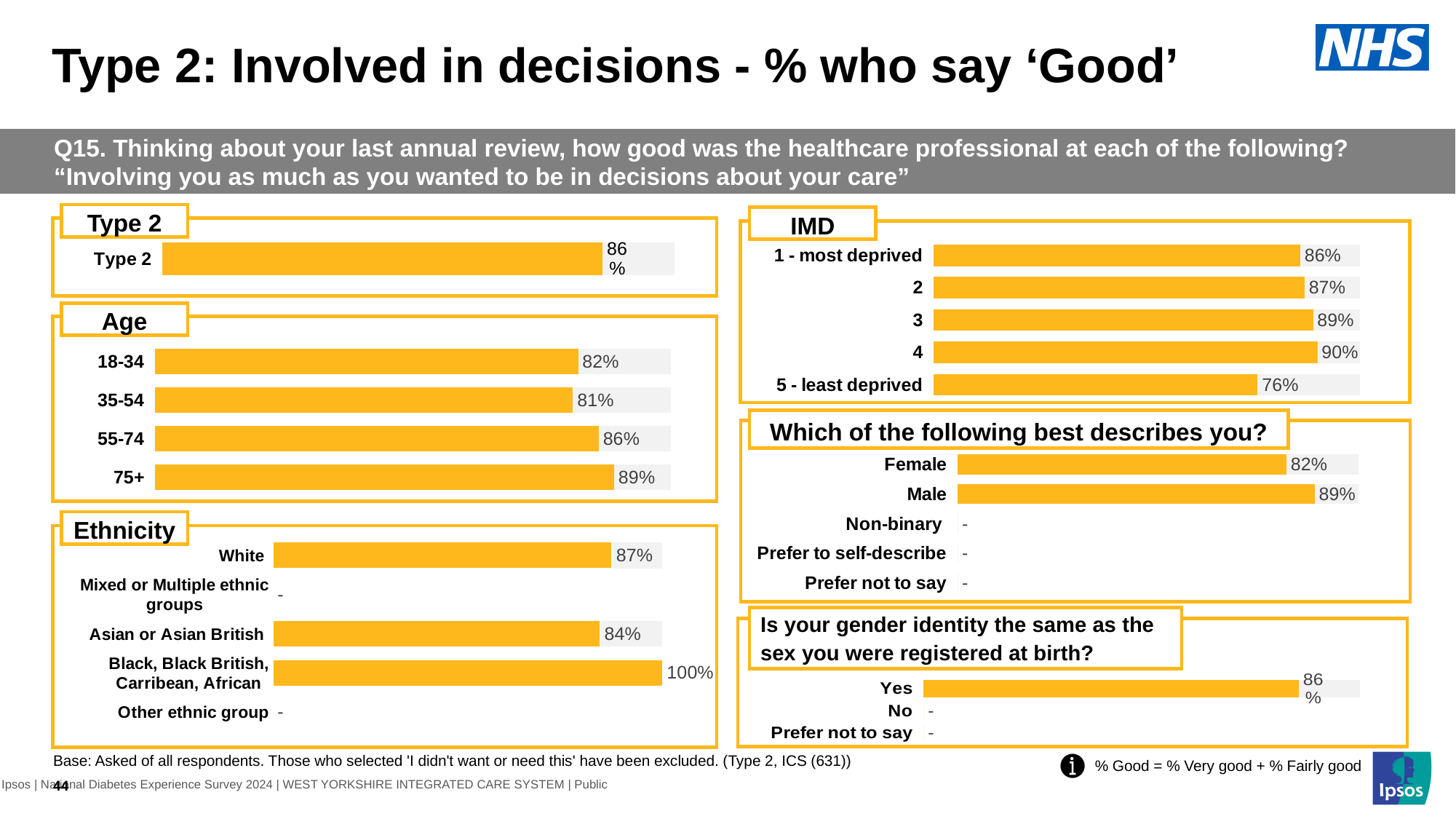
What type of chart is used in the IMD section? Bar chart How many age groups are shown in the Age chart? 4 In the Age chart, which age group has the lowest value? 35-54 In the Age chart, what is the value for 75+? 89% In the Ethnicity chart, which is larger, the value for White or the value for Asian or Asian British? White In the Ethnicity chart, what is the value for Black, Black British, Carribean, African? 100% In the IMD chart, which category has the highest value? 4 In the IMD chart, what is the difference between the values for 4 and 5 - least deprived? 14 percentage points In the 'Is your gender identity the same as the sex you were registered at birth?' chart, what is the value for Yes? 86% In the 'Which of the following best describes you?' chart, what is the value for Female? 82% In the IMD chart, what is the value for 5 - least deprived? 76% In the 'Which of the following best describes you?' chart, what is the difference between the values for Male and Female? 7 percentage points